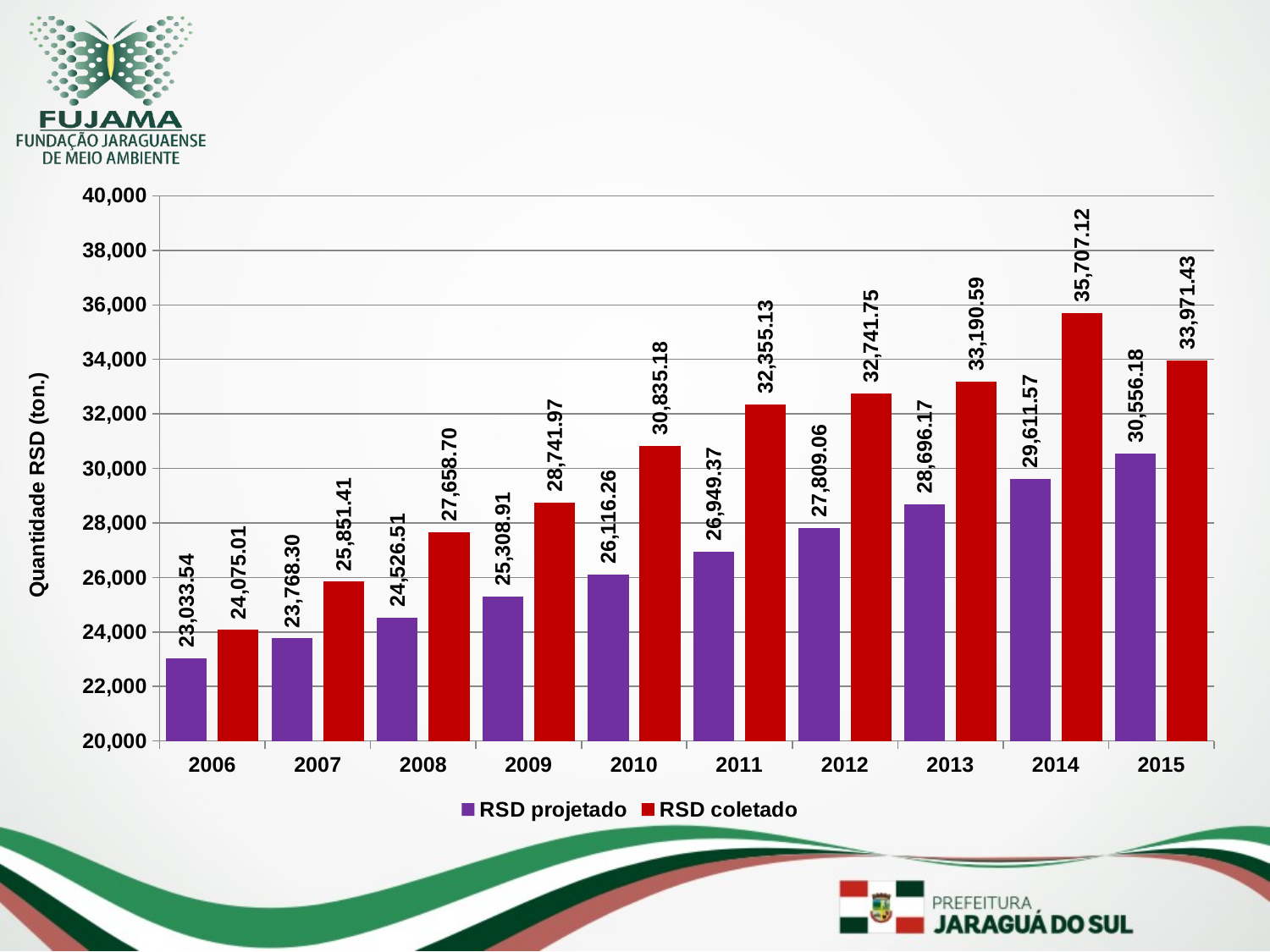
What is the value of RSD coletado for 2014? 35,707.12 What is the value of RSD projetado for 2010? 26,116.26 What is the difference between RSD coletado and RSD projetado in 2006? 1,041.47 Which is larger, RSD coletado in 2014 or RSD coletado in 2015? RSD coletado in 2014 What kind of chart is shown on the slide? Bar chart Which year has the lowest RSD projetado value? 2006 What is the value of RSD coletado for 2006? 24,075.01 Which year has the highest RSD coletado value? 2014 How many series does the legend list? 2 Do the RSD projetado values rise or fall from 2006 to 2015? Rise What is the difference between RSD coletado and RSD projetado in 2014? 6,095.55 How many years are shown on the x axis? 10